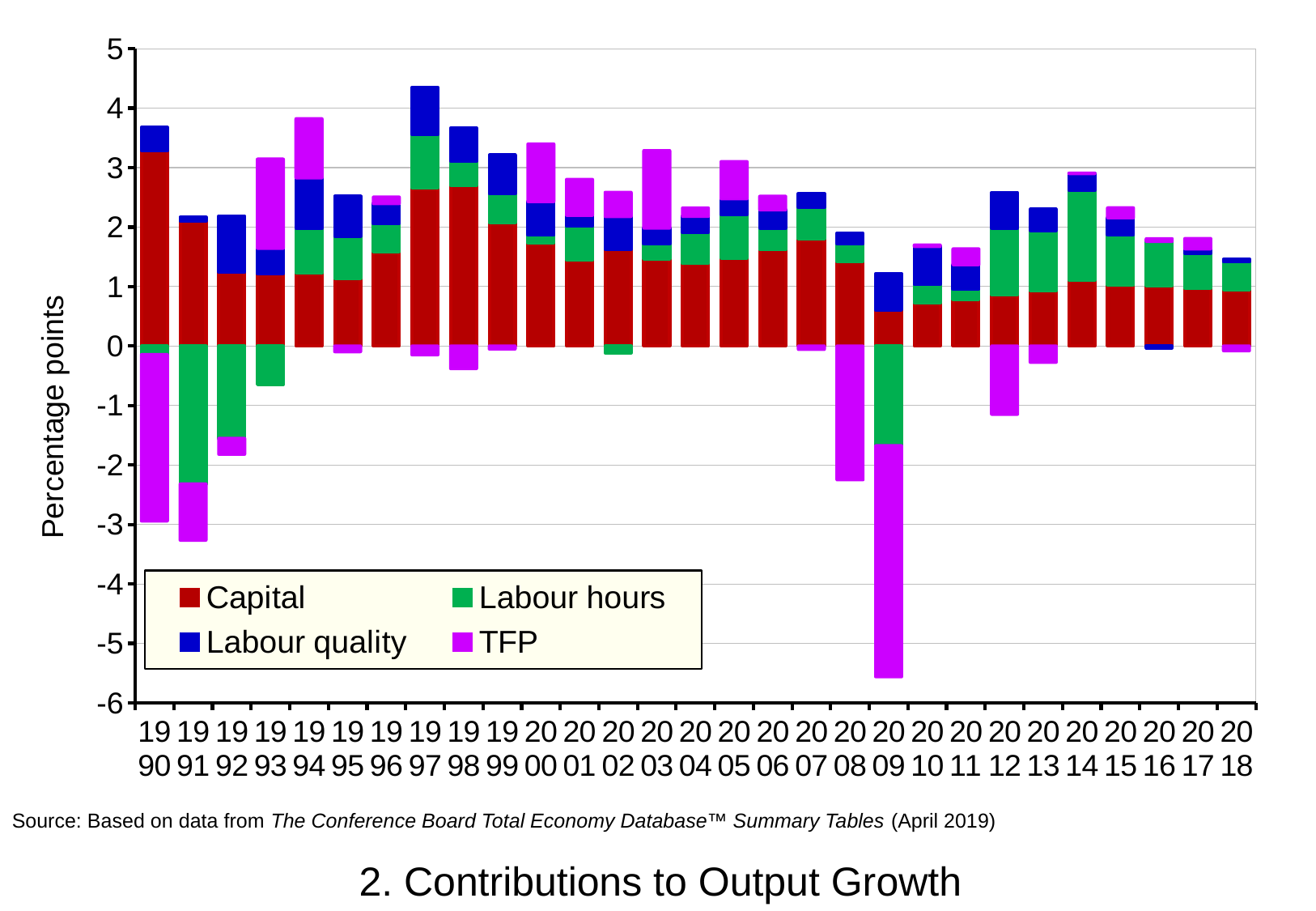
Which year has the largest Capital contribution? 1990 What is the title of the chart? 2. Contributions to Output Growth Which year has the most negative TFP contribution? 2009 Is the Capital contribution in 2009 greater or less than 1? less How many years are shown along the x axis? 29 Is the Capital contribution in 1990 greater or less than 3? greater Which is larger, the Capital contribution in 1990 or in 2009? 1990 What is the label on the vertical axis? Percentage points What kind of chart is shown on the slide? Stacked bar chart How many series does the legend list? 4 Is the Labour hours contribution in 2009 greater or less than -1? less